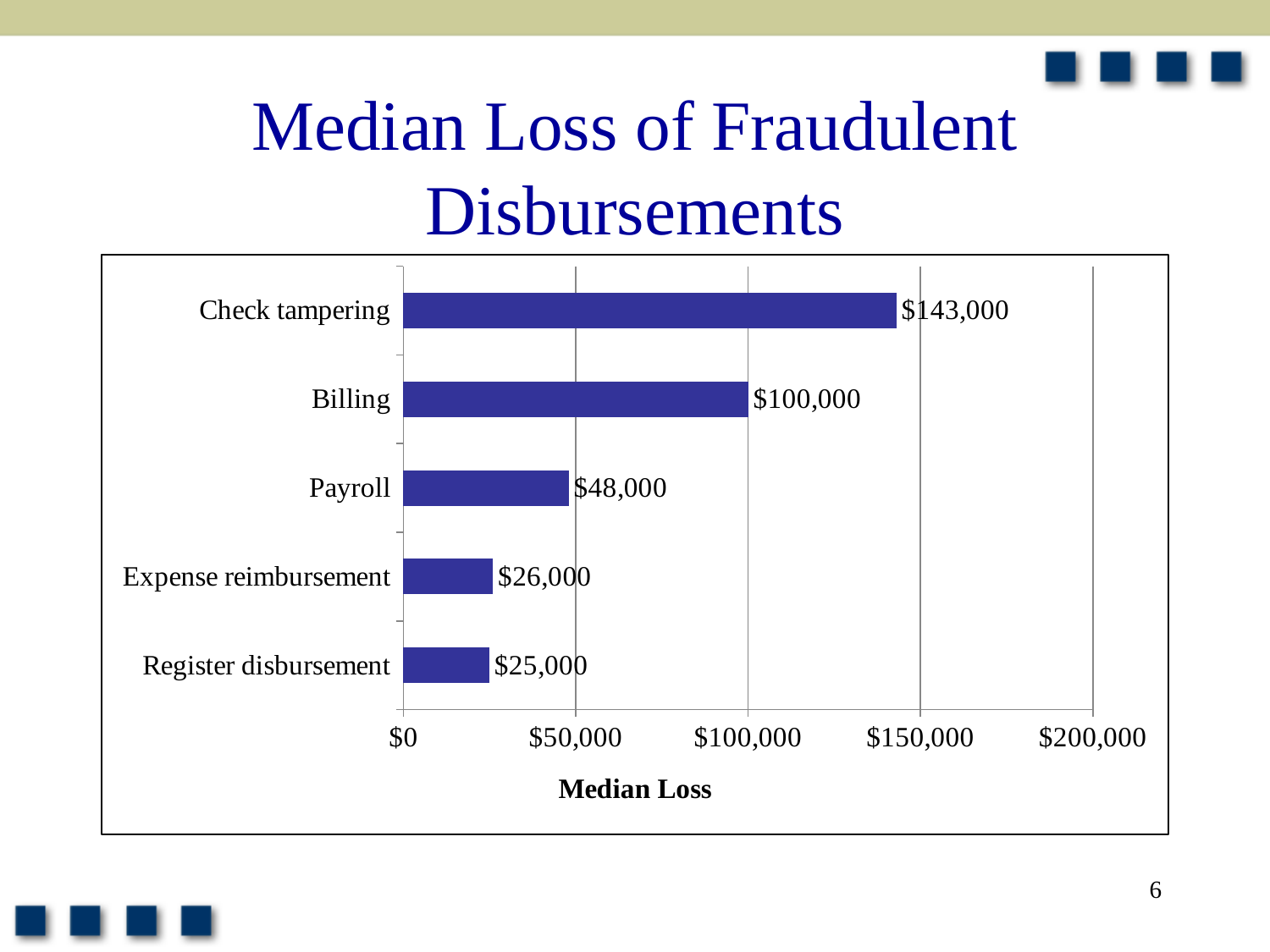
Which category has the lowest median loss? Register disbursement What is the difference between the median loss for Payroll and Register disbursement? $23,000 What kind of chart is shown on the slide? bar chart What is the median loss for Check tampering? $143,000 What is the median loss for Expense reimbursement? $26,000 Which category has the highest median loss? Check tampering Which has a larger median loss, Billing or Payroll? Billing How many categories are shown in the chart? 5 What is the difference between the median loss for Check tampering and Billing? $43,000 What is the label on the horizontal axis of the chart? Median Loss What is the median loss for Payroll? $48,000 Is the median loss for Payroll greater or less than $50,000? less